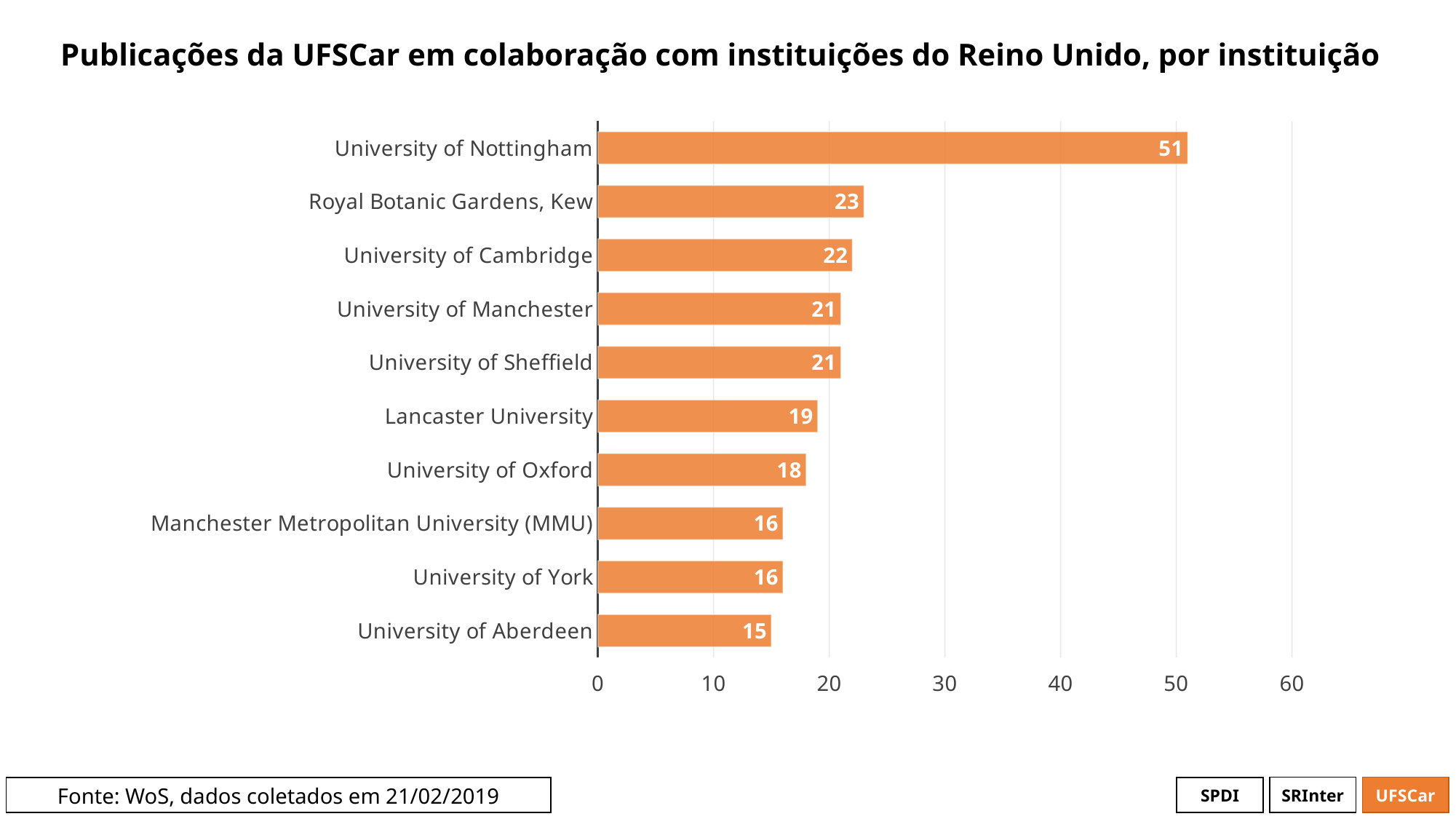
Which has a larger value, University of Cambridge or University of Manchester? University of Cambridge Is the value for University of Nottingham greater or less than 40? greater What is the value shown for University of Oxford? 18 How many institutions are shown in the chart? 10 What is the title of the chart? Publicações da UFSCar em colaboração com instituições do Reino Unido, por instituição How many publications does the chart show for University of Nottingham? 51 Which institution has the lowest number of publications in the chart? University of Aberdeen What is the difference between the values for Lancaster University and University of York? 3 What is the value shown for Royal Botanic Gardens, Kew? 23 What kind of chart is shown on the slide? Bar chart What is the difference between the values for University of Nottingham and University of Cambridge? 29 Which institution has the highest number of publications in the chart? University of Nottingham